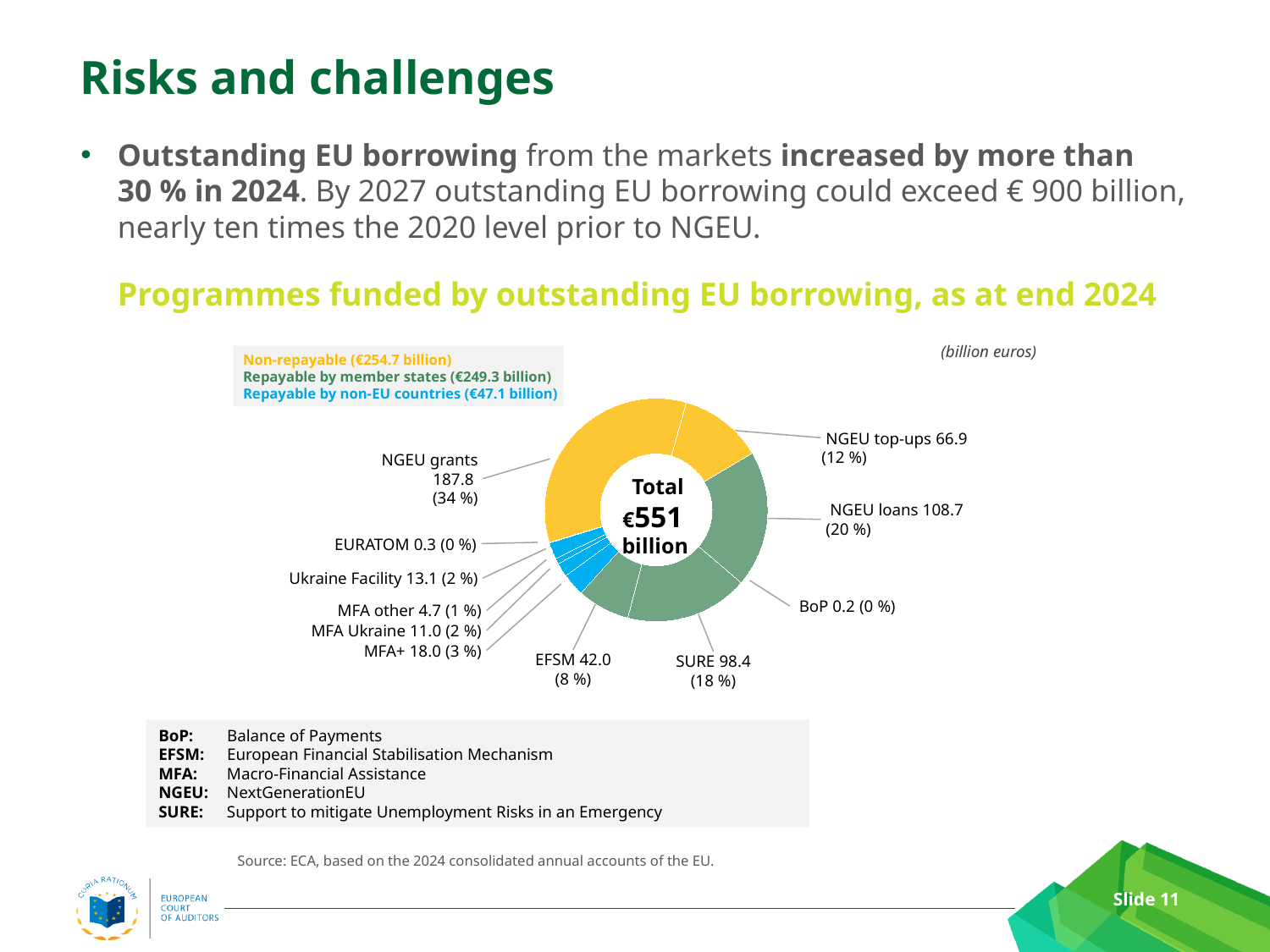
What is the value for SURE? 98.4 What share of the total does NGEU top-ups represent? 12 % Which programme has the smallest value in the chart? BoP What share of the total does EFSM represent? 8 % Which is larger, MFA+ or Ukraine Facility? MFA+ What is the value for NGEU loans? 108.7 How many programmes are shown in the chart? 11 What is the value for NGEU grants? 187.8 Which programme has the largest share of outstanding EU borrowing? NGEU grants What kind of chart is shown on the slide? Pie chart (donut) What is the difference between NGEU loans and SURE? 10.3 What total is shown in the centre of the chart? €551 billion